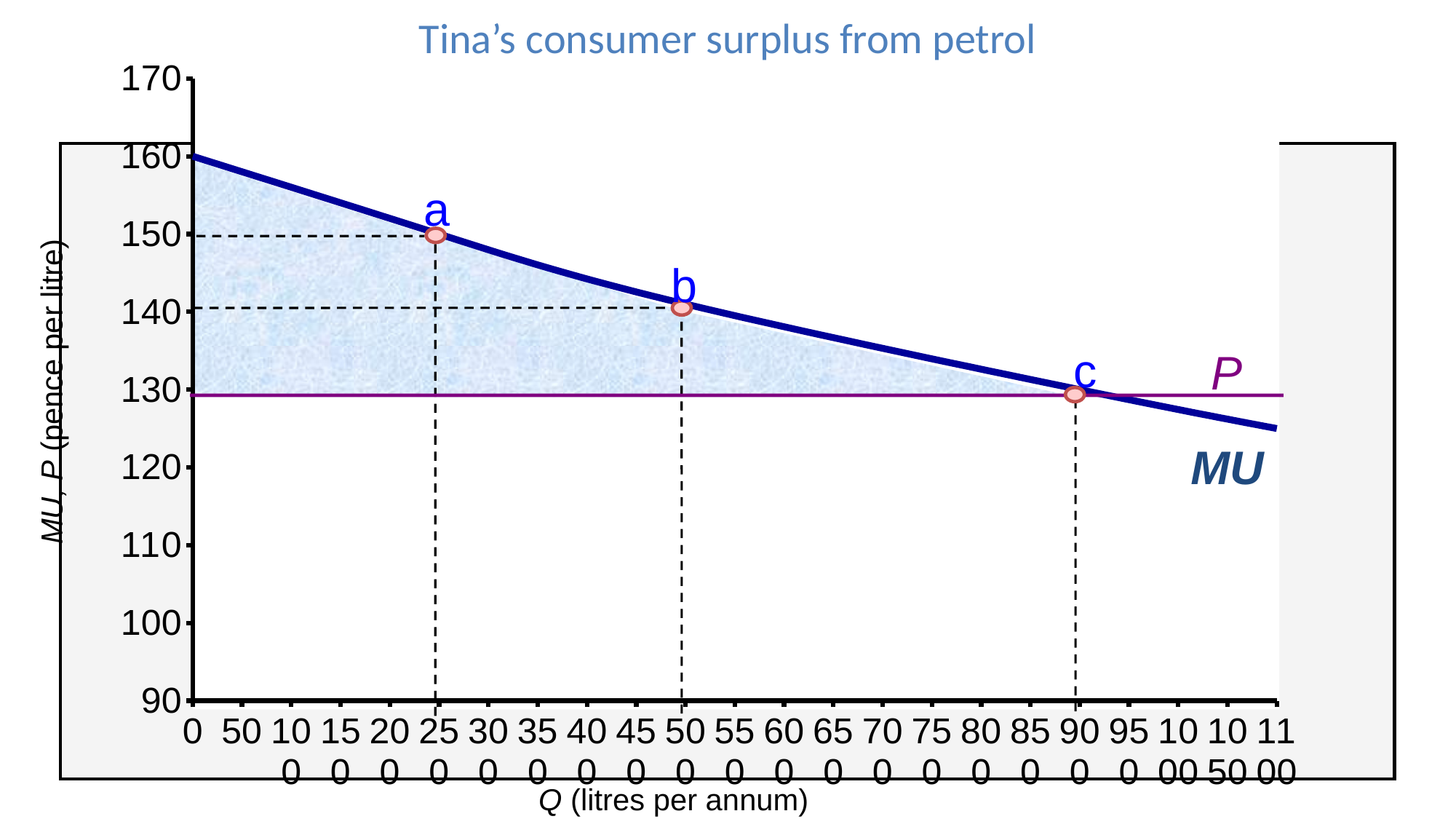
At what quantity Q is point c located? 900 What kind of chart is shown on the slide? line chart How many labelled points (a, b, c) are marked on the MU curve? 3 What is the title of the chart? Tina's consumer surplus from petrol Is the value of MU at Q = 1100 greater or less than 130? less What is the value of MU at point a? 150 At what quantity Q is point a located? 250 Which point has the higher MU value, point b or point c? point b What price level does the horizontal line P sit at? 130 Does the MU curve rise or fall as Q increases? fall